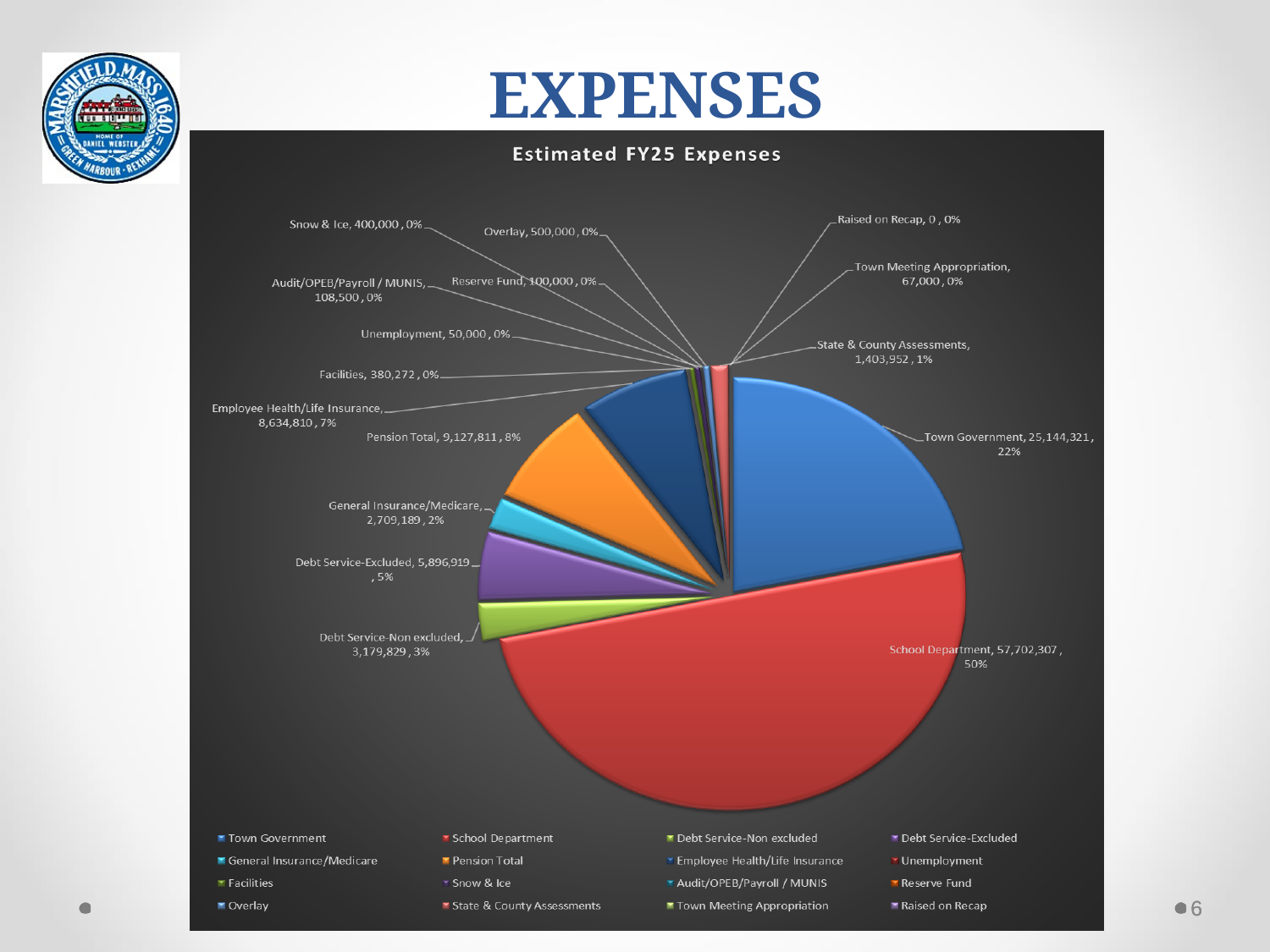
Which category has the largest share of the Estimated FY25 Expenses pie? School Department What percentage share of the pie does Employee Health/Life Insurance represent? 7% What is the value shown for State & County Assessments? 1,403,952 What is the value shown for Pension Total? 9,127,811 Which is larger, the value for Pension Total or the value for Employee Health/Life Insurance? Pension Total Which category has the smallest value in the Estimated FY25 Expenses pie? Raised on Recap What percentage share of the pie does School Department represent? 50% What is the title of the chart? Estimated FY25 Expenses How many categories does the legend list? 16 What is the value shown for Town Government? 25,144,321 What kind of chart is shown on the slide? pie chart What is the difference between the values for Debt Service-Excluded and Debt Service-Non excluded? 2,717,090